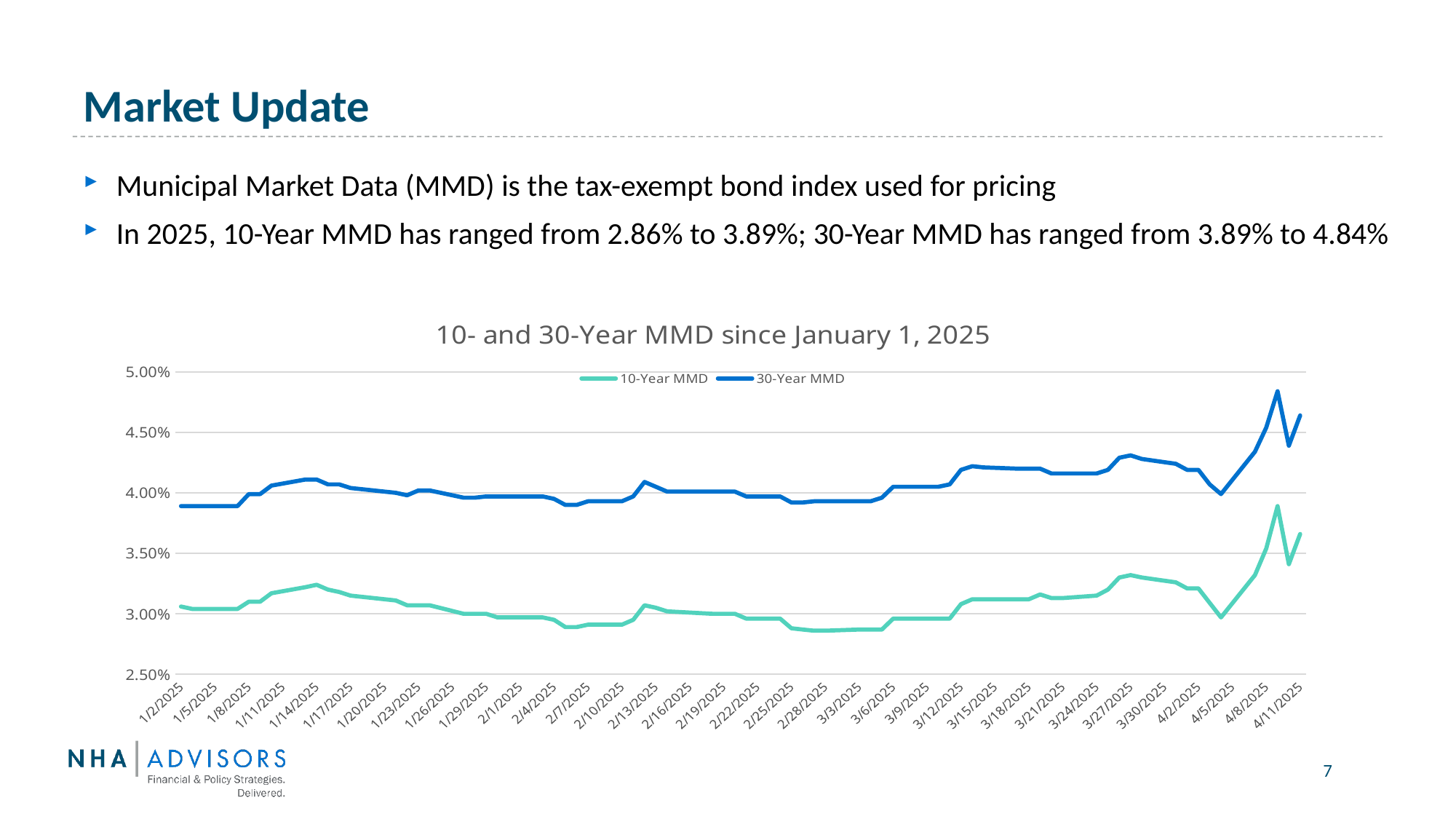
Is the value of 30-Year MMD on 1/2/2025 greater or less than 4.00%? less Overall, does the 30-Year MMD line rise or fall from 1/2/2025 to 4/11/2025? Rise What is the title of the chart? 10- and 30-Year MMD since January 1, 2025 Which series is drawn in dark blue in the chart? 30-Year MMD Is the value of 30-Year MMD on 3/27/2025 greater or less than 4.00%? greater In which month does the 30-Year MMD reach its highest value on the chart? April 2025 What kind of chart is shown on the slide? Line chart How many series does the chart legend list? 2 Is the value of 10-Year MMD on 2/28/2025 greater or less than 3.00%? less On 4/8/2025, which series has the higher value, 10-Year MMD or 30-Year MMD? 30-Year MMD